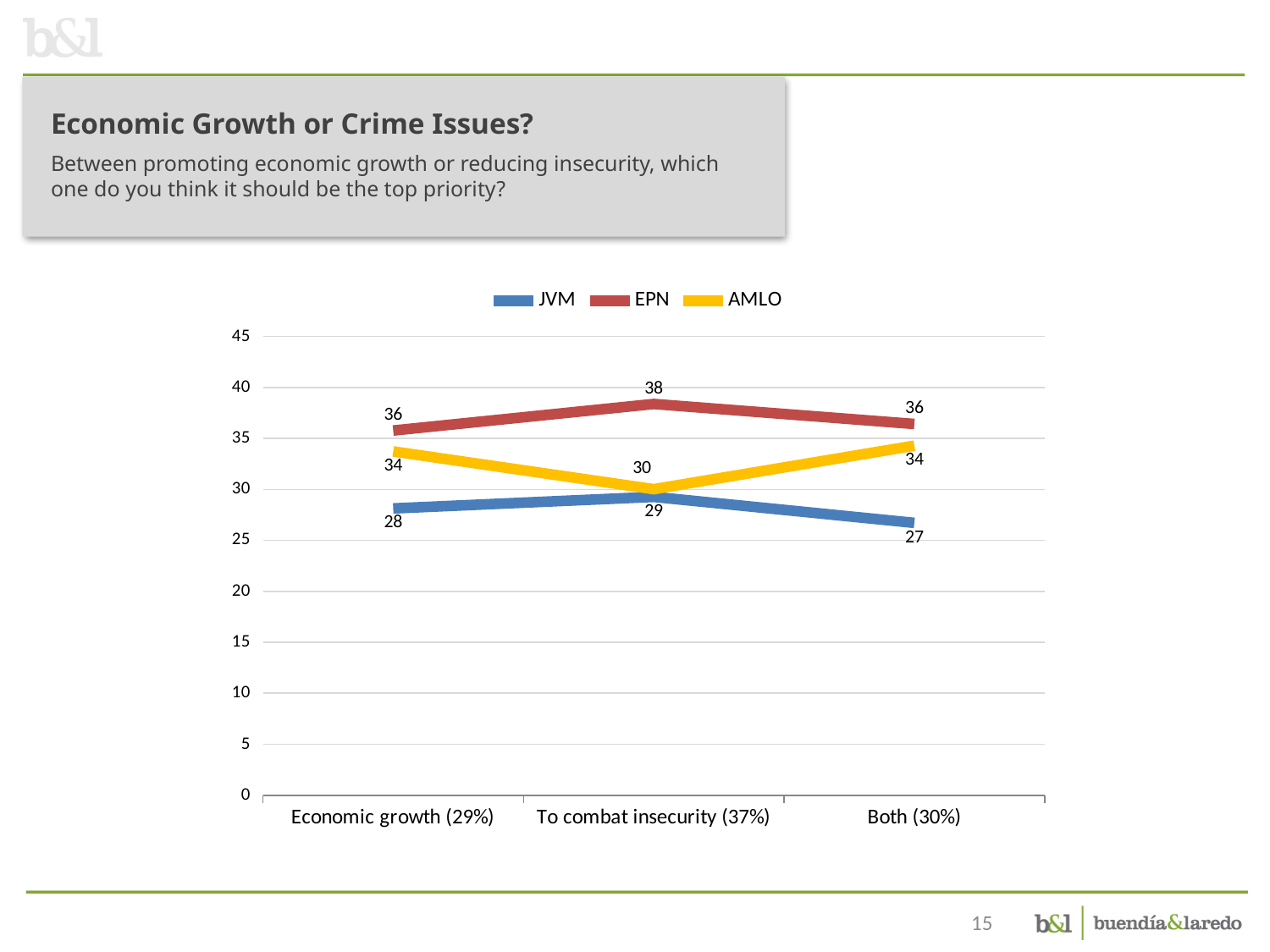
Does the JVM line rise or fall from "To combat insecurity (37%)" to "Both (30%)"? Fall What is the value for JVM at "Both (30%)"? 27 Which is larger: the AMLO value at "Both (30%)" or the AMLO value at "To combat insecurity (37%)"? Both (30%) What kind of chart is shown on the slide? Line chart What is the value for EPN at "To combat insecurity (37%)"? 38 What colour is the EPN line? Red Which series has the highest value at "To combat insecurity (37%)"? EPN What is the value for AMLO at "Economic growth (29%)"? 34 How many series does the legend list? 3 What is the difference between the EPN and JVM values at "Economic growth (29%)"? 8 How many categories are shown on the x axis? 3 Which series has the lowest value at "Both (30%)"? JVM